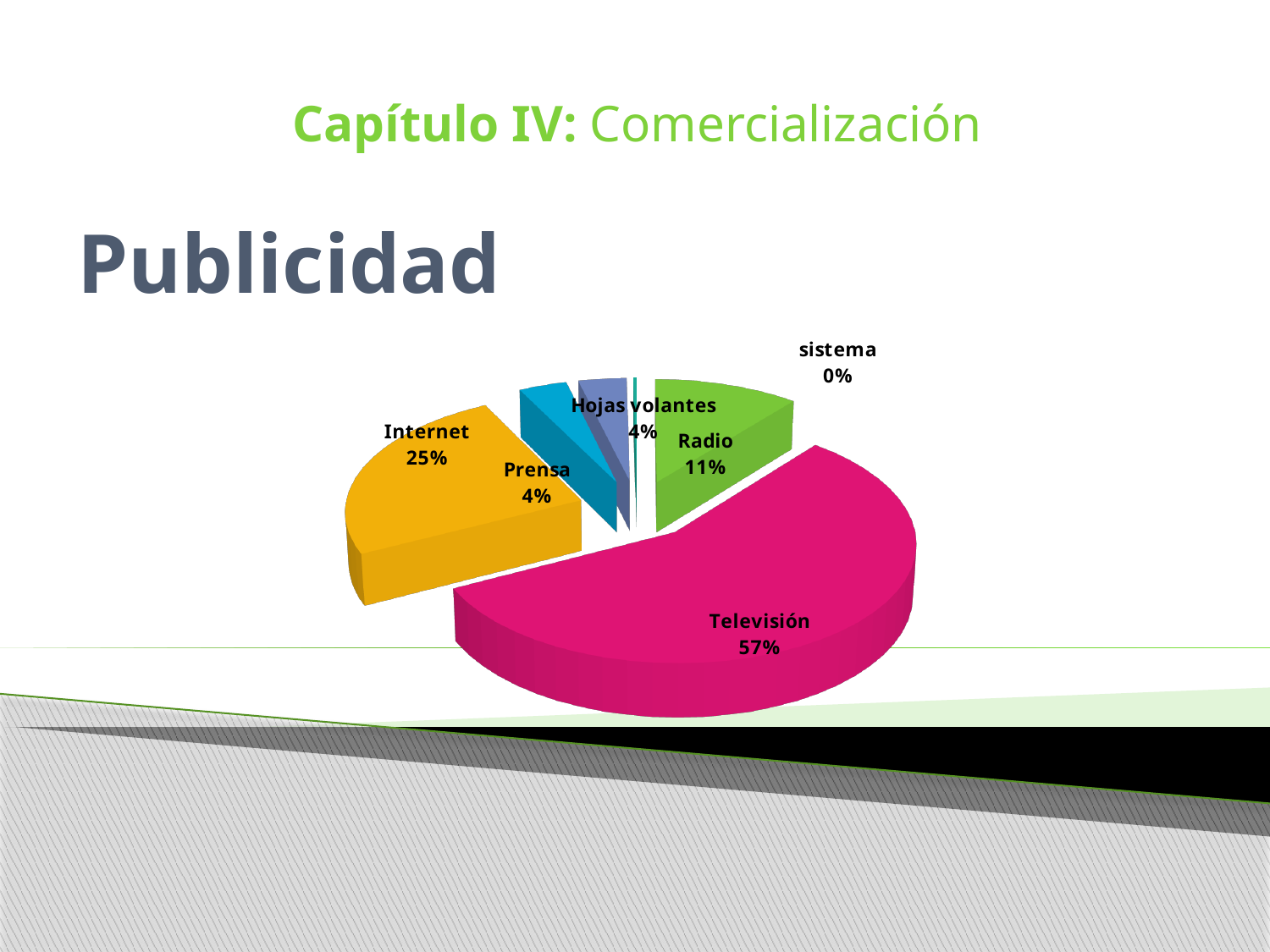
Which is larger, the share for Radio or the share for Prensa? Radio What percentage is shown for Prensa? 4% What share of the pie does Televisión have? 57% What percentage is shown for sistema? 0% What kind of chart is shown on the slide? Pie chart Which category has the largest slice of the pie? Televisión Which category has the smallest slice of the pie? sistema What percentage is shown for Internet? 25% What percentage is shown for Radio? 11% What is the difference in percentage points between Televisión and Internet? 32 How many categories are shown in the pie chart? 6 What colour is the Televisión slice? Pink (magenta)